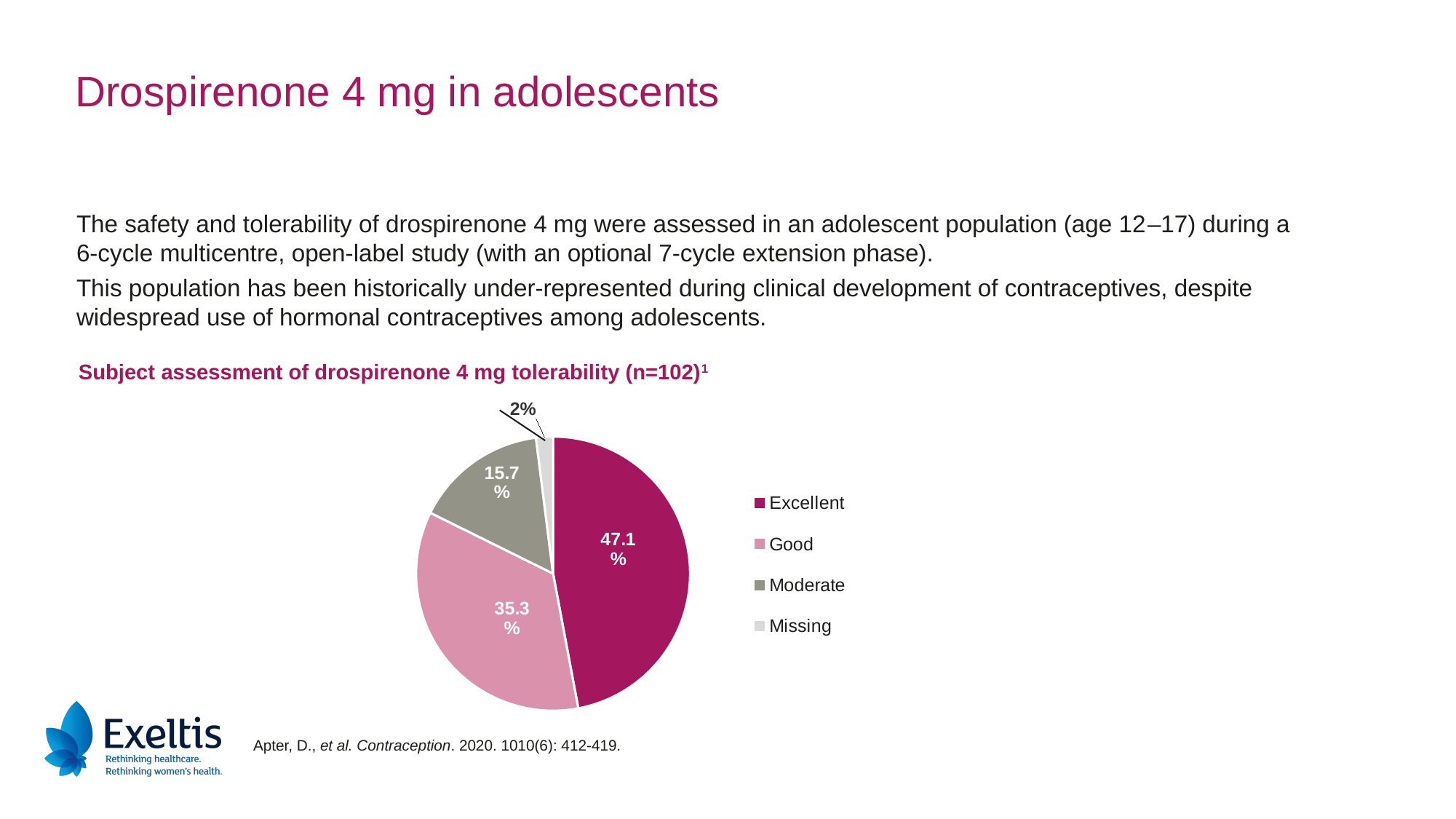
Which is larger, the Good slice or the Moderate slice? Good What percentage of responses are Missing? 2% What is the difference in percentage points between the Excellent and Good slices? 11.8 Which category has the smallest share of the pie? Missing What percentage of subjects rated tolerability as Good? 35.3% How many categories does the legend list? 4 Which category has the largest share of the pie? Excellent What percentage of subjects rated tolerability as Moderate? 15.7% What percentage of subjects rated tolerability as Excellent? 47.1% What kind of chart is shown on the slide? Pie chart What colour is the Moderate slice? Grey What is the title of the chart? Subject assessment of drospirenone 4 mg tolerability (n=102)